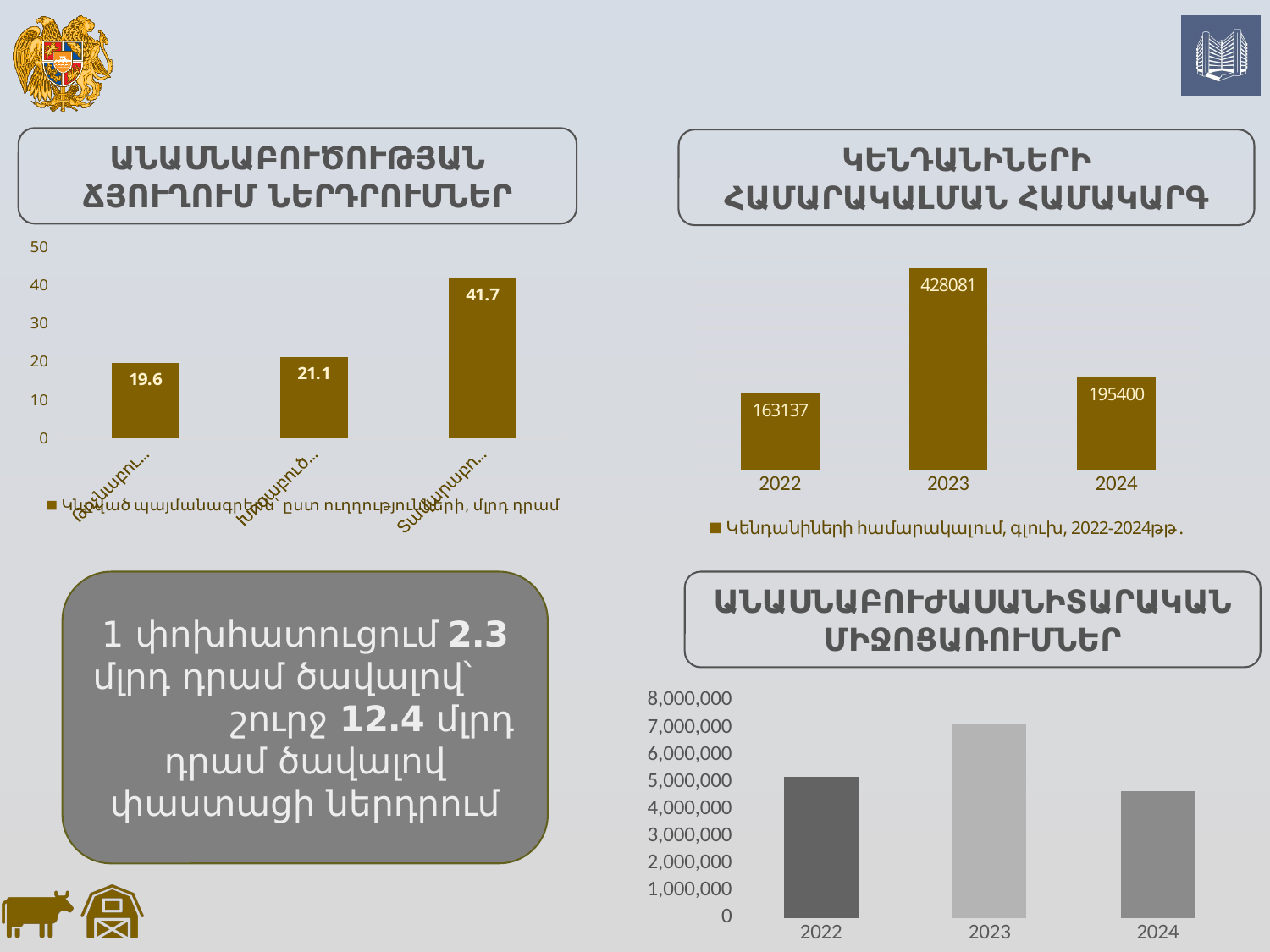
What kind of chart is the one titled ԱՆԱՍՆԱԲՈՒԺԱՍԱՆԻՏԱՐԱԿԱՆ ՄԻՋՈՑԱՌՈՒՄՆԵՐ (bottom right)? bar chart In the chart titled ԱՆԱՍՆԱԲՈՒԺԱՍԱՆԻՏԱՐԱԿԱՆ ՄԻՋՈՑԱՌՈՒՄՆԵՐ (bottom right), is the value for 2024 greater or less than 5,000,000? less In the chart titled ԱՆԱՍՆԱԲՈՒԾՈՒԹՅԱՆ ՃՅՈՒՂՈՒՄ ՆԵՐԴՐՈՒՄՆԵՐ (top left), what is the value of the first (leftmost) bar? 19.6 In the chart titled ԱՆԱՍՆԱԲՈՒԺԱՍԱՆԻՏԱՐԱԿԱՆ ՄԻՋՈՑԱՌՈՒՄՆԵՐ (bottom right), is the value for 2023 greater or less than 6,000,000? greater In the chart titled ԱՆԱՍՆԱԲՈՒԺԱՍԱՆԻՏԱՐԱԿԱՆ ՄԻՋՈՑԱՌՈՒՄՆԵՐ (bottom right), which year has the highest value? 2023 In the chart titled ԿԵՆԴԱՆԻՆԵՐԻ ՀԱՄԱՐԱԿԱԼՄԱՆ ՀԱՄԱԿԱՐԳ (top right), what is the difference between the 2023 and 2024 values? 232681 In the chart titled ԿԵՆԴԱՆԻՆԵՐԻ ՀԱՄԱՐԱԿԱԼՄԱՆ ՀԱՄԱԿԱՐԳ (top right), which is larger, the value for 2022 or the value for 2024? 2024 In the chart titled ԱՆԱՍՆԱԲՈՒԾՈՒԹՅԱՆ ՃՅՈՒՂՈՒՄ ՆԵՐԴՐՈՒՄՆԵՐ (top left), what is the value of the third (rightmost) bar? 41.7 In the chart titled ԱՆԱՍՆԱԲՈՒԾՈՒԹՅԱՆ ՃՅՈՒՂՈՒՄ ՆԵՐԴՐՈՒՄՆԵՐ (top left), how many bars are plotted? 3 In the chart titled ԱՆԱՍՆԱԲՈՒԾՈՒԹՅԱՆ ՃՅՈՒՂՈՒՄ ՆԵՐԴՐՈՒՄՆԵՐ (top left), what is the difference between the third bar and the second bar? 20.6 In the chart titled ԿԵՆԴԱՆԻՆԵՐԻ ՀԱՄԱՐԱԿԱԼՄԱՆ ՀԱՄԱԿԱՐԳ (top right), what is the value for 2023? 428081 In the chart titled ԿԵՆԴԱՆԻՆԵՐԻ ՀԱՄԱՐԱԿԱԼՄԱՆ ՀԱՄԱԿԱՐԳ (top right), which year has the lowest value? 2022